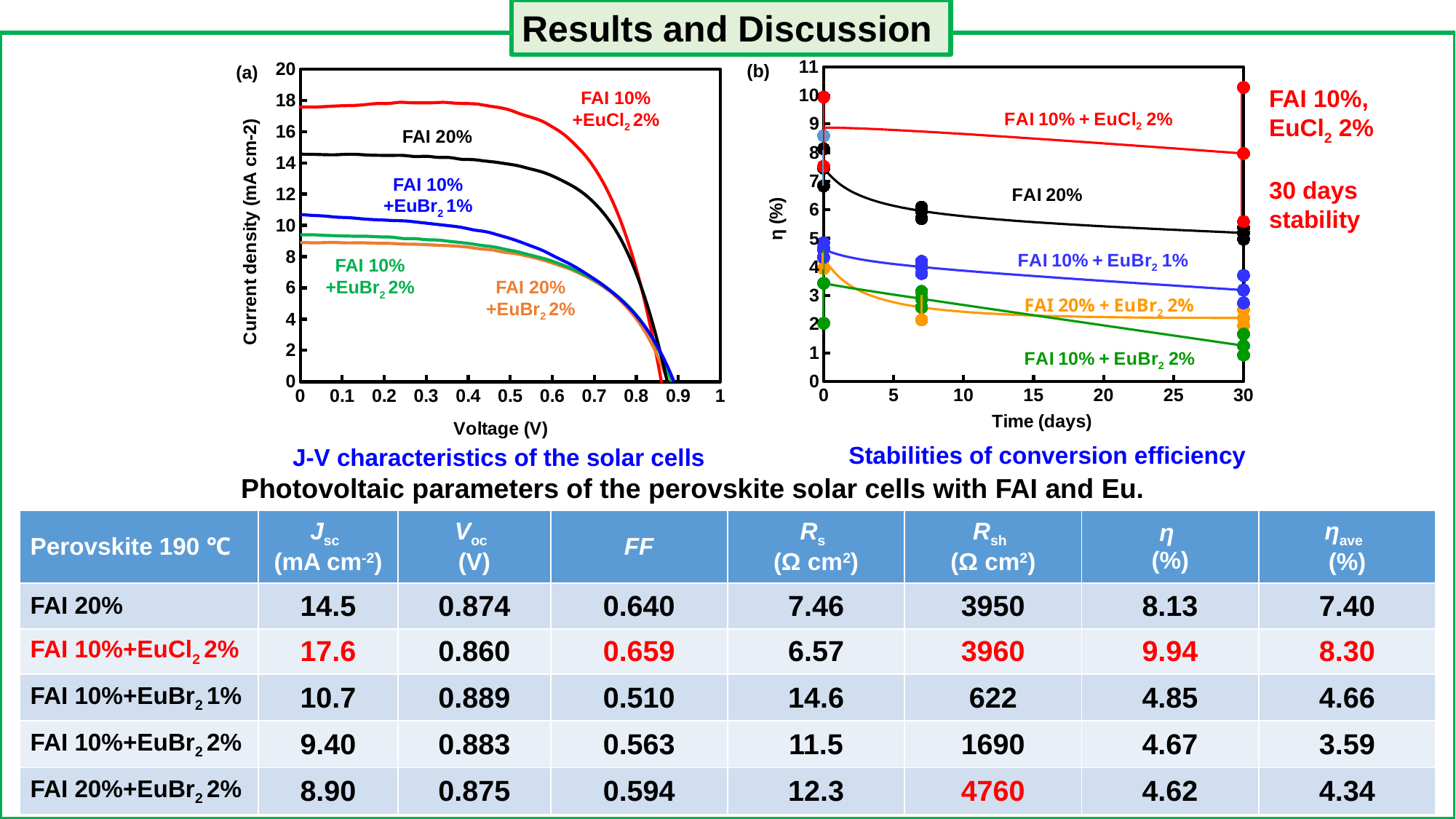
In chart (a), the J-V characteristics, which sample has the highest current density at 0 V? FAI 10% +EuCl2 2% In chart (a), the J-V characteristics, does the current density rise or fall as voltage increases? fall In chart (b), the stabilities of conversion efficiency, which sample has the lowest efficiency at 30 days? FAI 10% + EuBr2 2% In chart (b), the stabilities of conversion efficiency, is the efficiency of FAI 10% + EuCl2 2% at 30 days greater or less than 7%? greater What is the x-axis label of chart (b), the stabilities of conversion efficiency? Time (days) In chart (a), the J-V characteristics, how many curves (samples) are plotted? 5 In chart (b), the stabilities of conversion efficiency, is the efficiency of FAI 20% at 30 days greater or less than 6%? less In chart (b), the stabilities of conversion efficiency, which sample has the highest efficiency at 30 days? FAI 10% + EuCl2 2% In chart (a), the J-V characteristics, is the current density of FAI 10% +EuBr2 1% at 0 V greater or less than 12 mA cm-2? less What kind of chart is chart (a), the J-V characteristics of the solar cells? line chart In chart (b), the stabilities of conversion efficiency, which is higher at 30 days: FAI 20% or FAI 10% + EuBr2 1%? FAI 20%